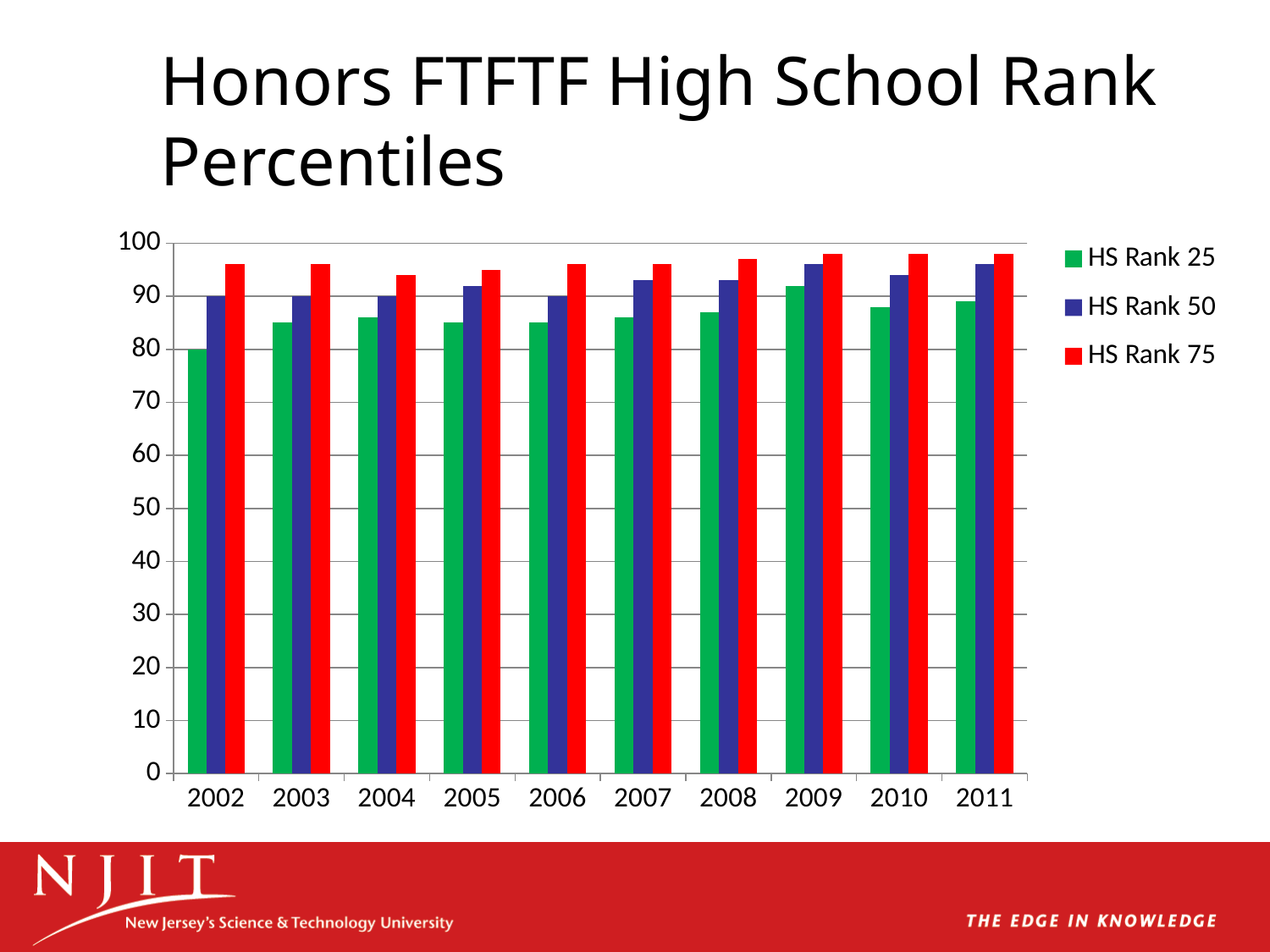
What is the value for HS Rank 25 in 2002? 80 In which year is the HS Rank 25 value lowest? 2002 How many years are shown on the x axis? 10 Do the HS Rank 25 values generally rise or fall from 2002 to 2011? rise In 2002, which is larger: HS Rank 75 or HS Rank 25? HS Rank 75 What kind of chart is shown on the slide? bar chart Is the value for HS Rank 25 in 2003 greater or less than 80? greater What is the value for HS Rank 50 in 2002? 90 What colour represents HS Rank 75 in the legend? red How many series does the legend list? 3 Is the value for HS Rank 75 in 2002 greater or less than 90? greater Is the value for HS Rank 50 in 2010 greater or less than 90? greater